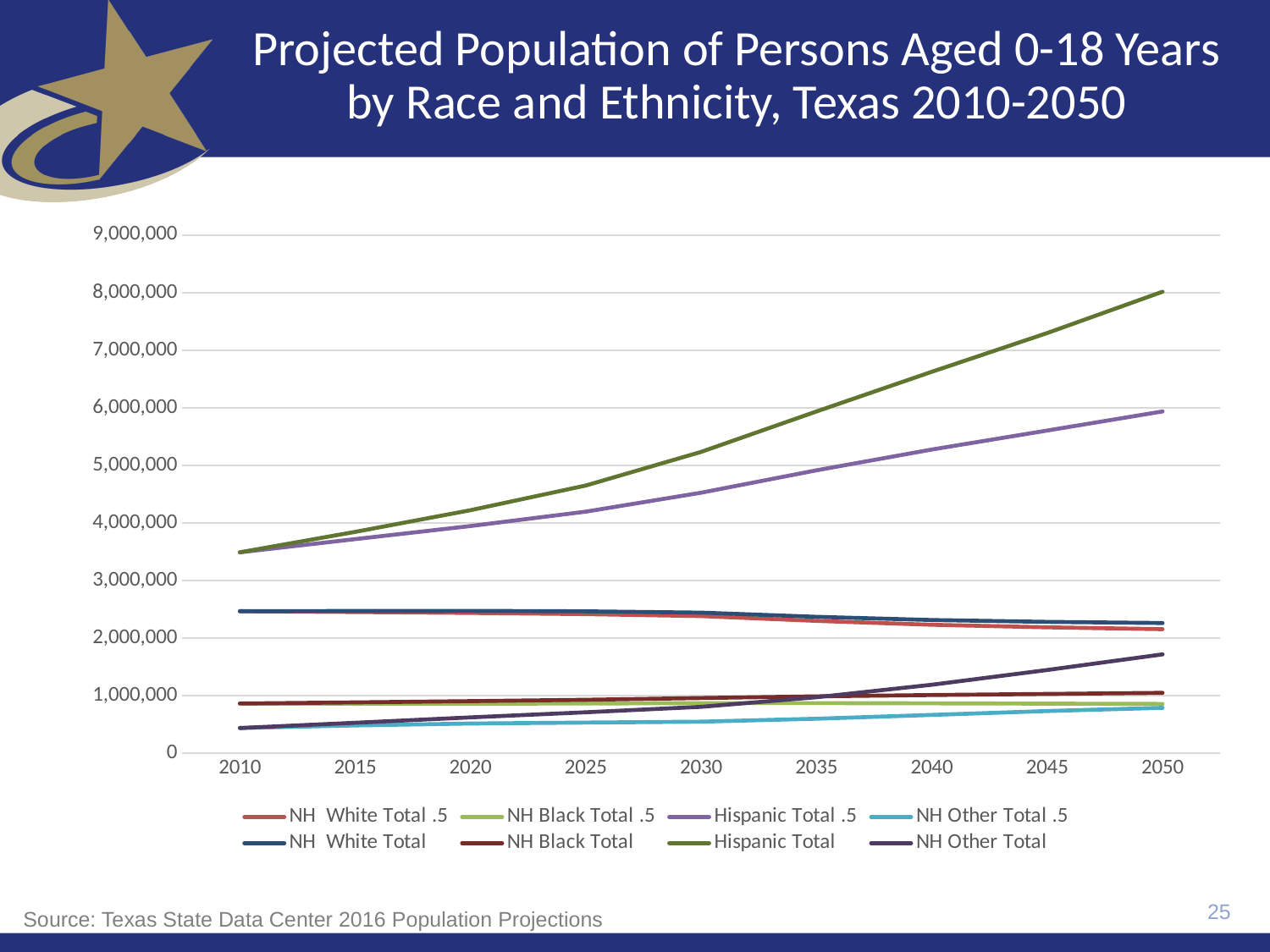
What is the title of the chart? Projected Population of Persons Aged 0-18 Years by Race and Ethnicity, Texas 2010-2050 Does the NH White Total .5 line rise or fall from 2010 to 2050? fall Is the value for Hispanic Total in 2010 greater or less than 3,000,000? greater How many series does the legend list? 8 Is the value for NH Other Total .5 in 2010 greater or less than 1,000,000? less Which series has the highest value in 2050? Hispanic Total Is the value for Hispanic Total in 2040 greater or less than 6,000,000? greater How many years are marked along the x axis? 9 Does the Hispanic Total line rise or fall from 2010 to 2050? rise What kind of chart is shown on the slide? line chart In 2050, which is larger: Hispanic Total or NH White Total? Hispanic Total